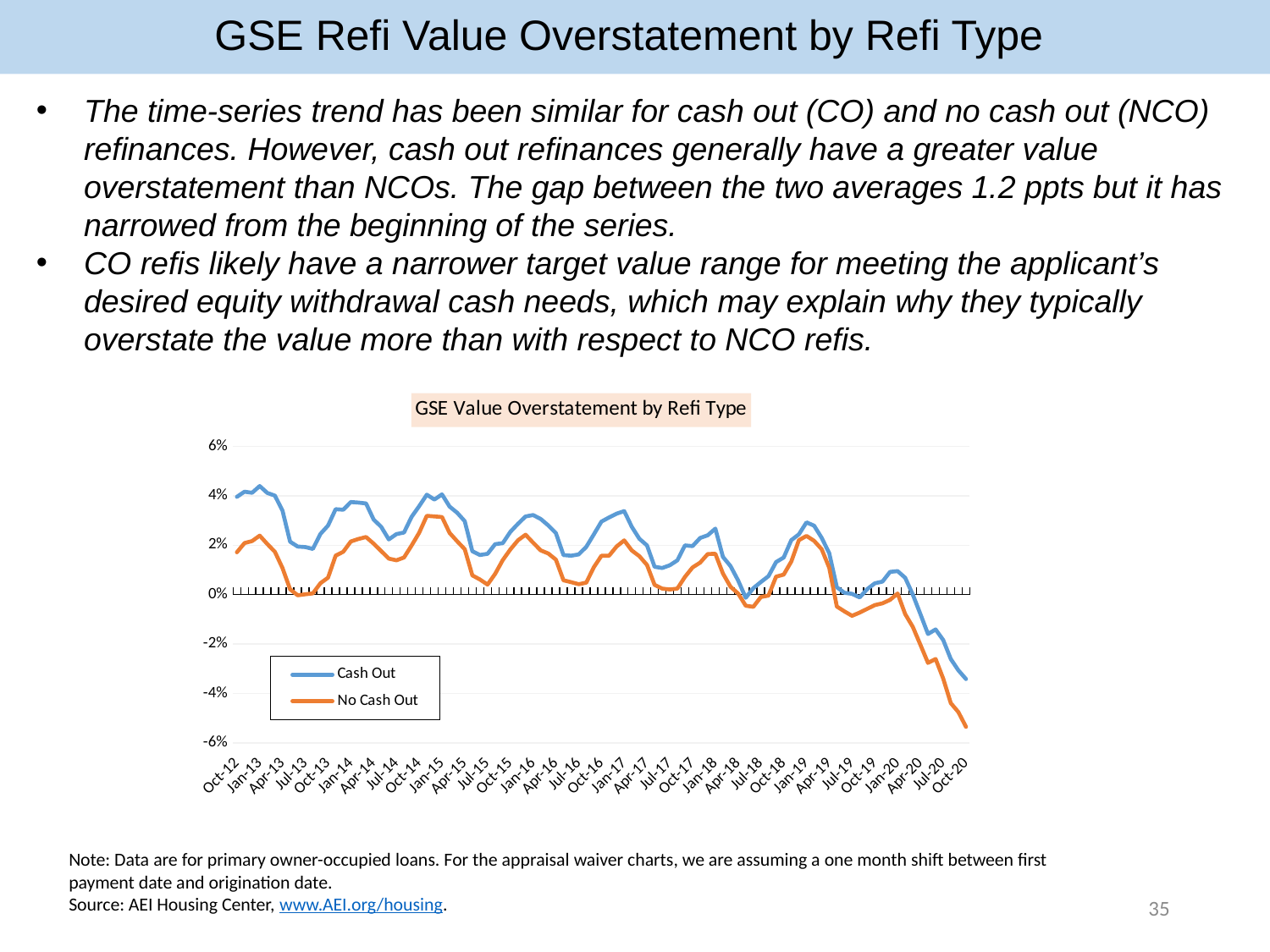
Is the Cash Out value at Oct-20 greater or less than -2%? less How many series does the chart legend list? 2 Is the Cash Out value at Jan-13 greater or less than 2%? greater What is the title of the chart? GSE Value Overstatement by Refi Type Is the No Cash Out value at Oct-20 greater or less than -4%? less Do the values for both series rise or fall overall from Oct-12 to Oct-20? fall Which series is drawn in orange in the chart? No Cash Out What type of chart is shown on the slide? Line chart Which series reaches the lowest value on the chart? No Cash Out At Oct-20, which series has the higher value, Cash Out or No Cash Out? Cash Out